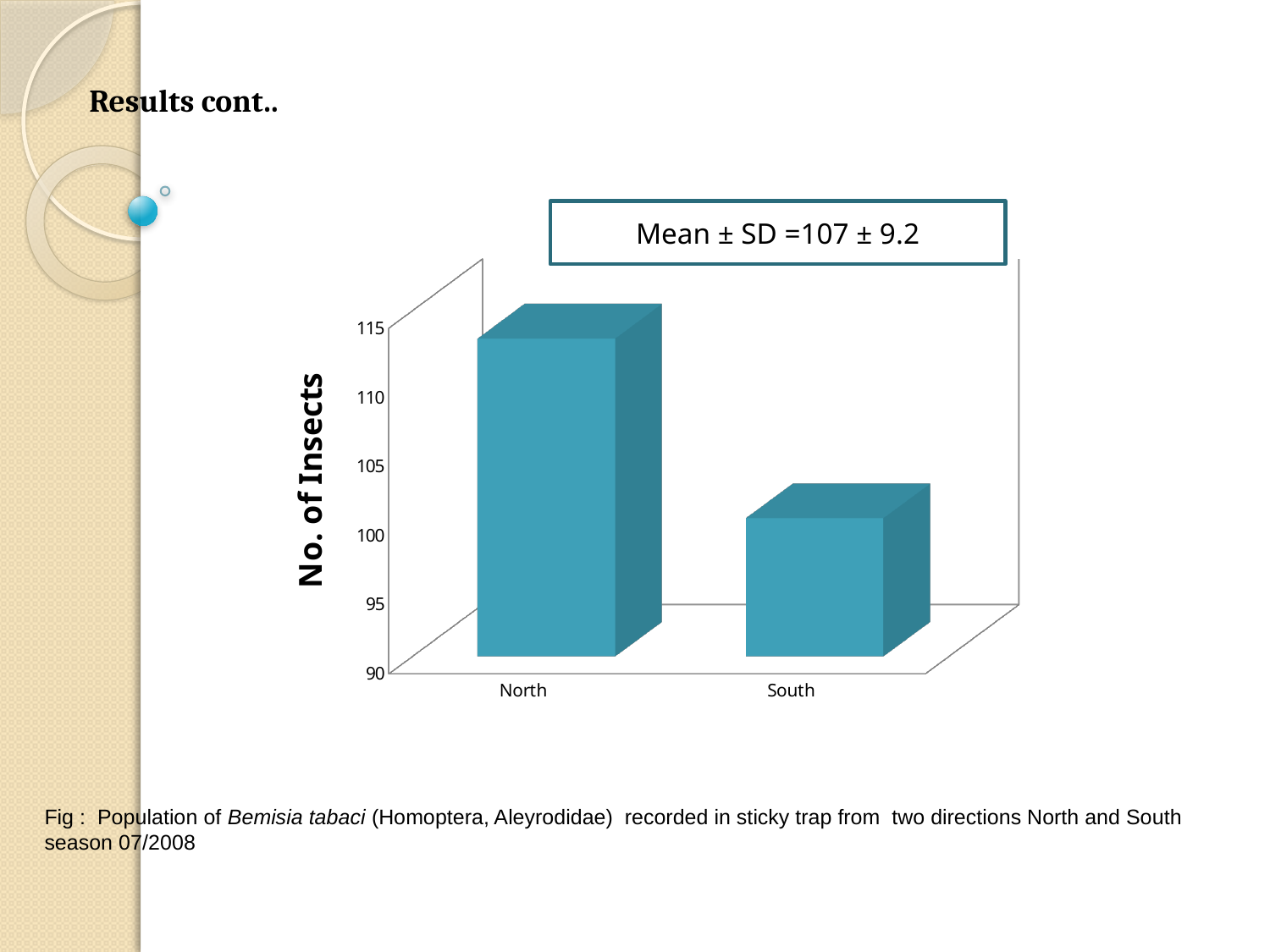
Which category has the highest bar in the chart? North What Mean ± SD value is shown in the box above the chart? 107 ± 9.2 Which direction has the higher number of insects, North or South? North Do the bar values rise or fall from North to South along the x axis? fall What kind of chart is shown on the slide? bar chart Is the value for South greater or less than 105? less Which category has the lowest bar in the chart? South What is the title of the vertical axis of the chart? No. of Insects Is the value for North greater or less than 105? greater How many categories are plotted on the x axis of the chart? 2 Is the value for North greater or less than 110? greater